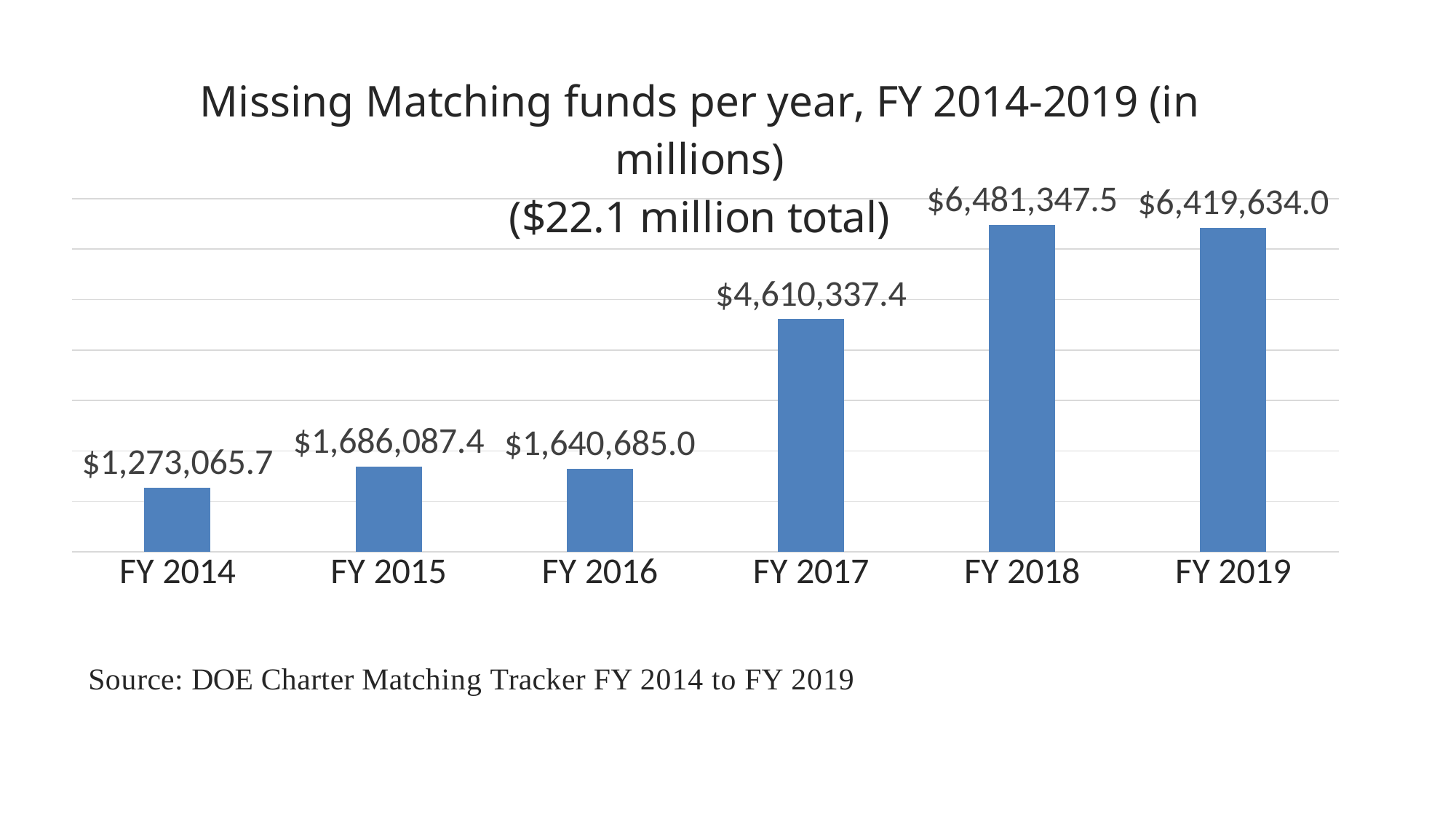
What is the value for FY 2019? $6,419,634.0 Which is larger, the value for FY 2017 or FY 2018? FY 2018 What is the value for FY 2014? $1,273,065.7 What kind of chart is shown on the slide? Bar chart Which is larger, the value for FY 2015 or FY 2016? FY 2015 Which fiscal year has the highest value? FY 2018 What is the difference between the values for FY 2015 and FY 2016? $45,402.4 Do the values generally rise or fall from FY 2014 to FY 2019? Rise Which fiscal year has the lowest value? FY 2014 What is the difference between the values for FY 2018 and FY 2019? $61,713.5 What is the value for FY 2017? $4,610,337.4 How many fiscal years are shown on the chart? 6